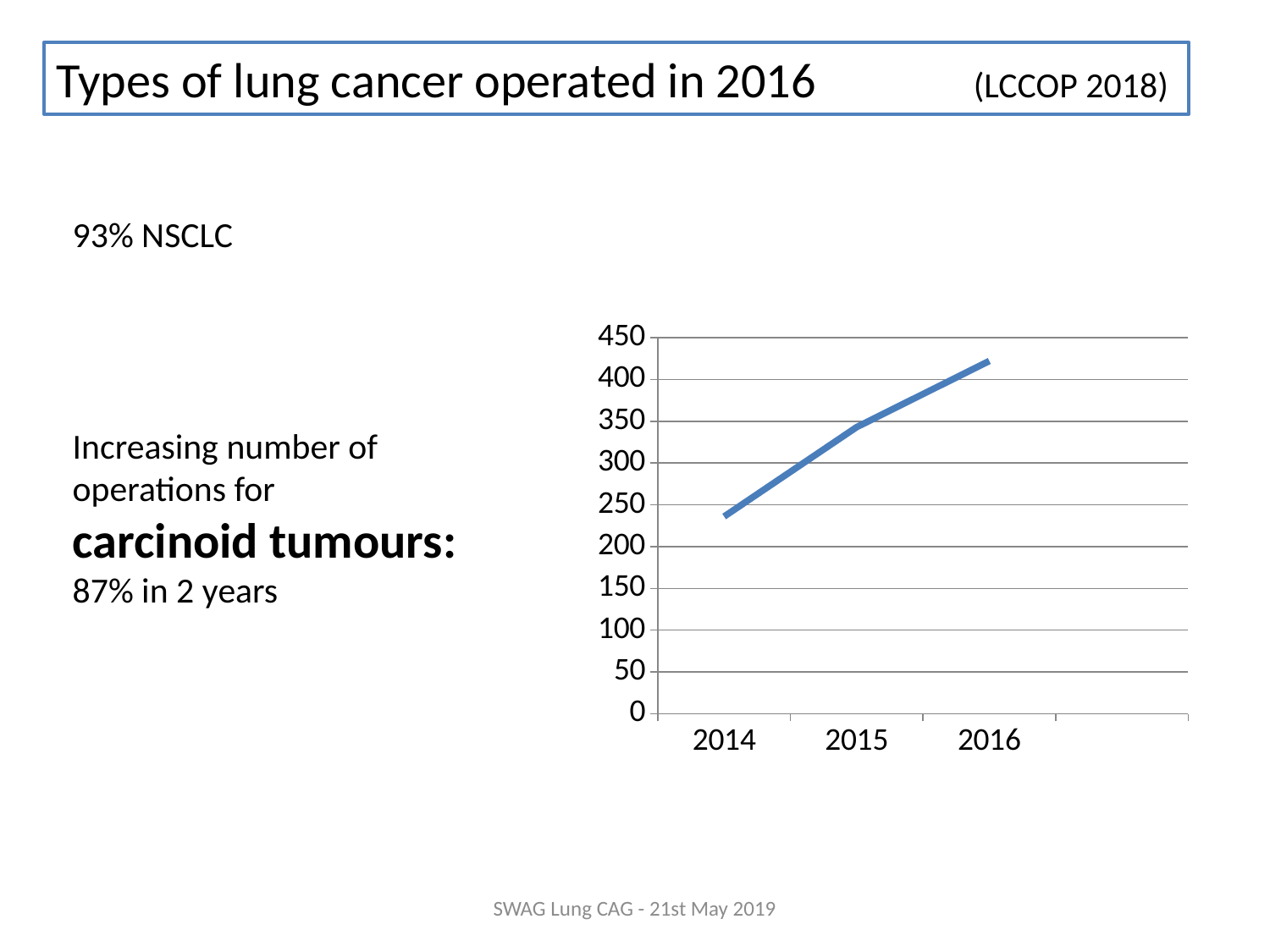
Is the value for 2014 greater or less than 200? greater Is the value for 2014 greater or less than 300? less Which year has the larger value, 2015 or 2016? 2016 Do the values in the chart rise or fall from 2014 to 2016? rise What is the highest value shown on the y axis of the chart? 450 Is the value for 2016 greater or less than 400? greater How many years are plotted on the x axis of the chart? 3 Which year has the lowest value in the chart? 2014 Which year has the highest value in the chart? 2016 Which year has the larger value, 2014 or 2015? 2015 What kind of chart is shown on the slide? line chart